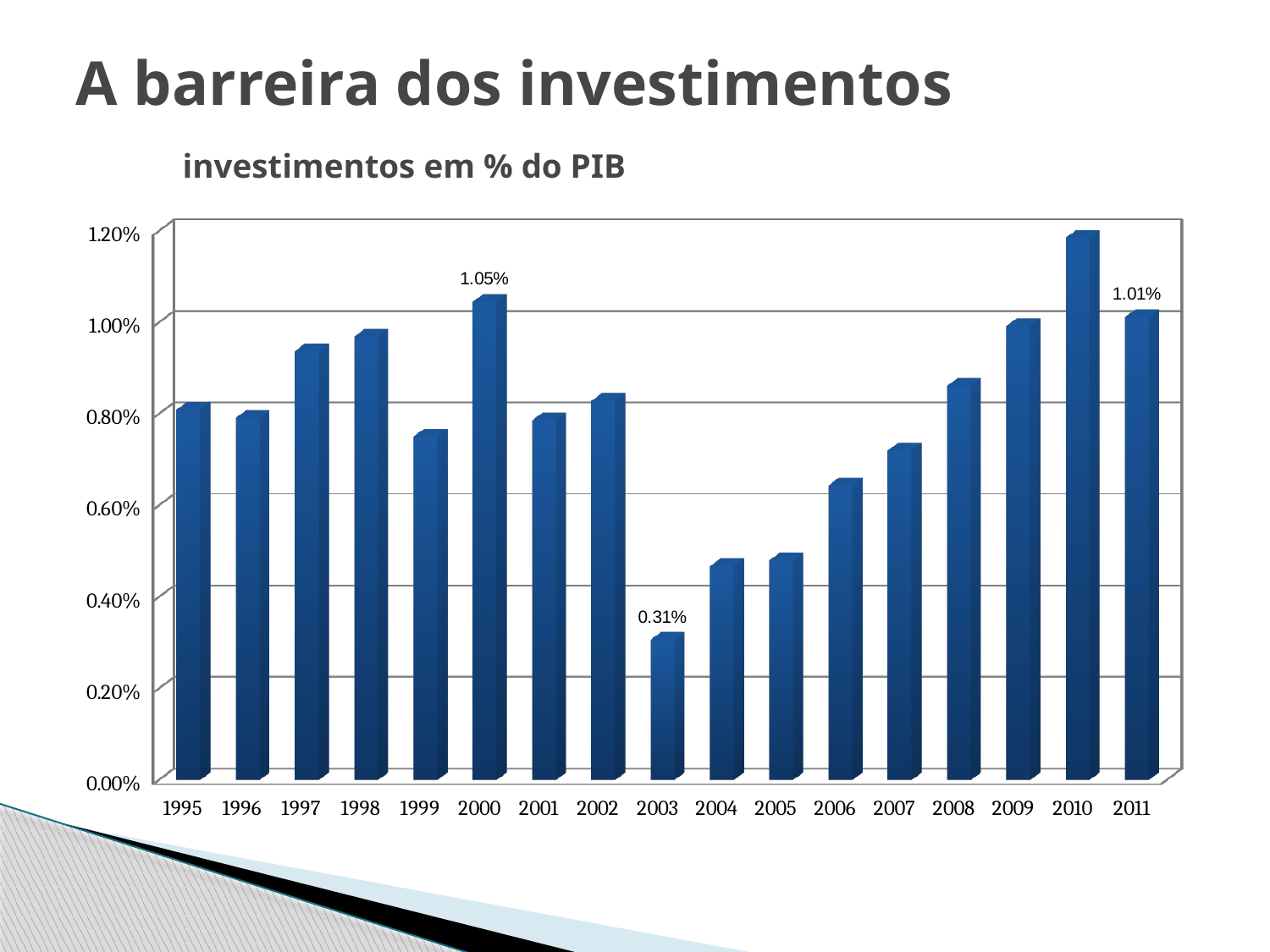
What is the value for 2000? 1.05% What is the value for 2003? 0.31% What type of chart is shown on the slide? bar chart How many years are shown on the x axis? 17 What is the value for 2011? 1.01% Which year has the lowest value? 2003 Which year has the highest value? 2010 Is the value for 2008 greater or less than 0.80%? greater Do the values rise or fall from 2003 to 2010? rise What is the difference between the values for 2000 and 2003? 0.74% Which is larger, the value for 2000 or the value for 2011? 2000 Is the value for 1999 greater or less than 0.80%? less